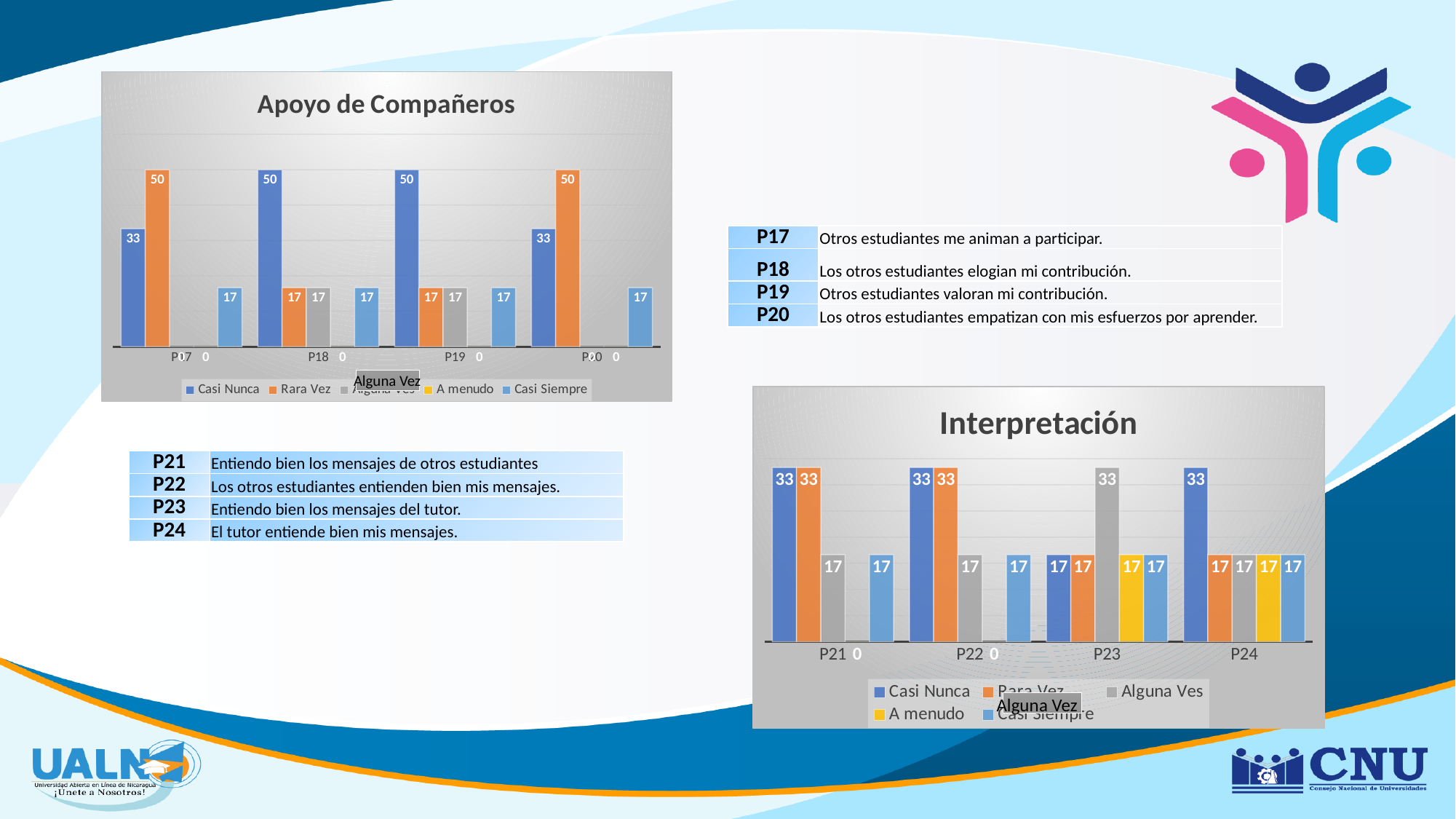
In the 'Interpretación' chart, what is the value of A menudo for P24? 17 In the 'Apoyo de Compañeros' chart, which series has the highest value for P19? Casi Nunca In the 'Apoyo de Compañeros' chart, what is the value of Casi Nunca for P18? 50 In the 'Apoyo de Compañeros' chart, how many categories are shown on the x axis? 4 In the 'Interpretación' chart, which series has the highest value for P24? Casi Nunca In the 'Apoyo de Compañeros' chart, what is the value of Casi Siempre for P20? 17 In the 'Interpretación' chart, which is larger for P22: Casi Nunca or Alguna Ves? Casi Nunca What type of chart is 'Interpretación'? Bar chart How many series does the legend of the 'Interpretación' chart list? 5 In the 'Apoyo de Compañeros' chart, what is the value of Rara Vez for P17? 50 In the 'Apoyo de Compañeros' chart, what is the difference between Rara Vez and Casi Nunca for P20? 17 In the 'Interpretación' chart, what is the value of Alguna Ves for P23? 33